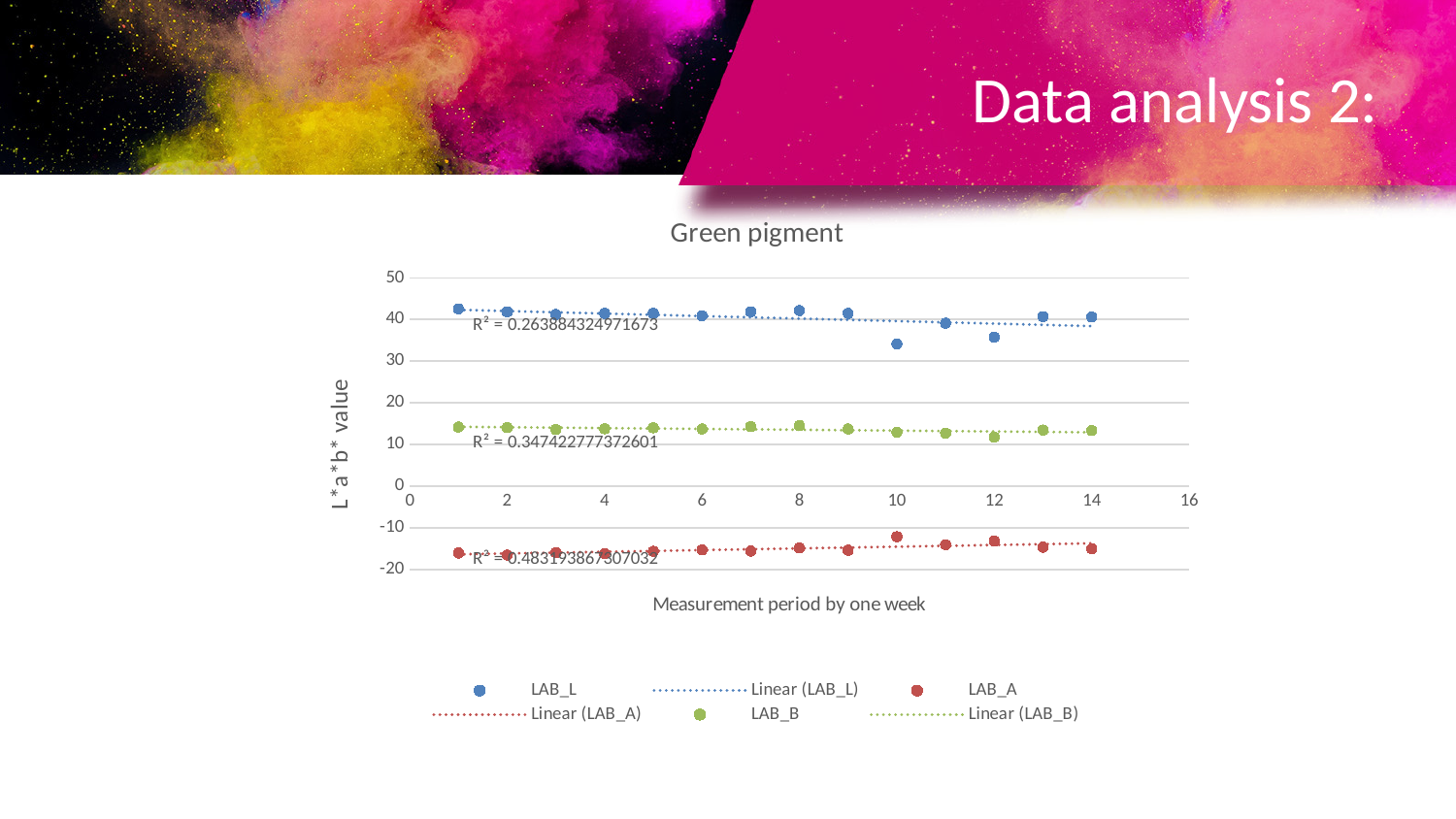
Is the LAB_B value at week 12 greater or less than 10? greater What kind of chart is shown on the slide? Scatter chart Is the LAB_L value at week 1 greater or less than 40? greater How many entries does the chart legend list? 6 Is the LAB_L value at week 10 greater or less than 40? less How many data points are plotted for the LAB_L series? 14 What is the title of the chart? Green pigment Does the linear trendline for LAB_A rise or fall along the x axis? rise Which series has the lowest values on the chart: LAB_L, LAB_A or LAB_B? LAB_A At week 5, which is larger, the LAB_L value or the LAB_B value? LAB_L What is the x-axis title of the chart? Measurement period by one week